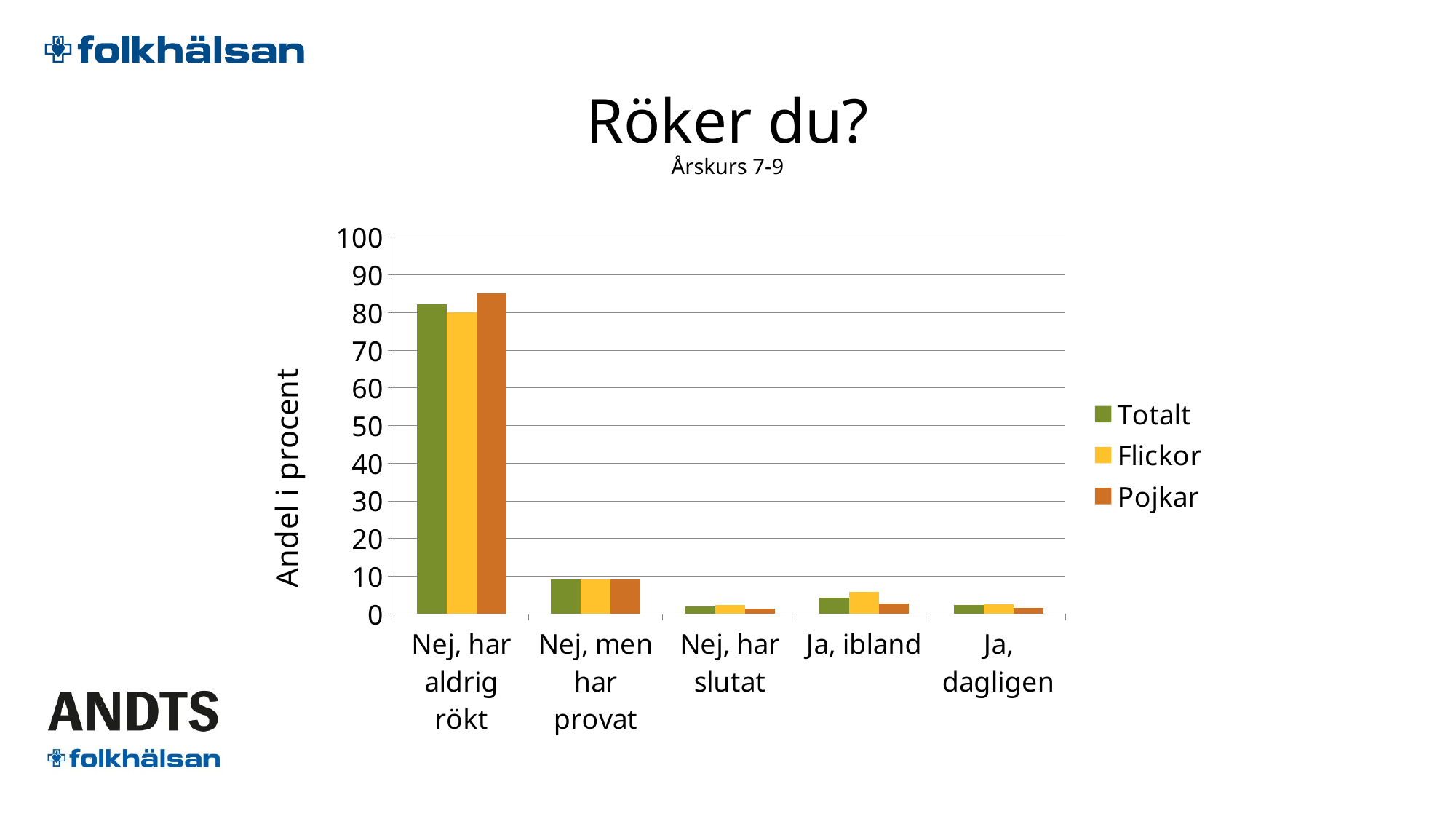
What is the subtitle shown under the chart title 'Röker du?'? Årskurs 7-9 How many series does the legend list? 3 What is the label of the vertical axis? Andel i procent Which category has the highest value for Totalt? Nej, har aldrig rökt Is the Totalt value for 'Nej, men har provat' greater or less than 20? less Which series has the highest value in the 'Ja, ibland' category? Flickor Is the Pojkar value for 'Nej, har aldrig rökt' greater or less than 80? greater How many answer categories are shown on the x axis? 5 For 'Nej, har aldrig rökt', which is larger: Flickor or Pojkar? Pojkar What kind of chart is shown on the slide? bar chart Is the Totalt value for 'Nej, har aldrig rökt' greater or less than 70? greater For 'Ja, ibland', which is larger: Flickor or Pojkar? Flickor